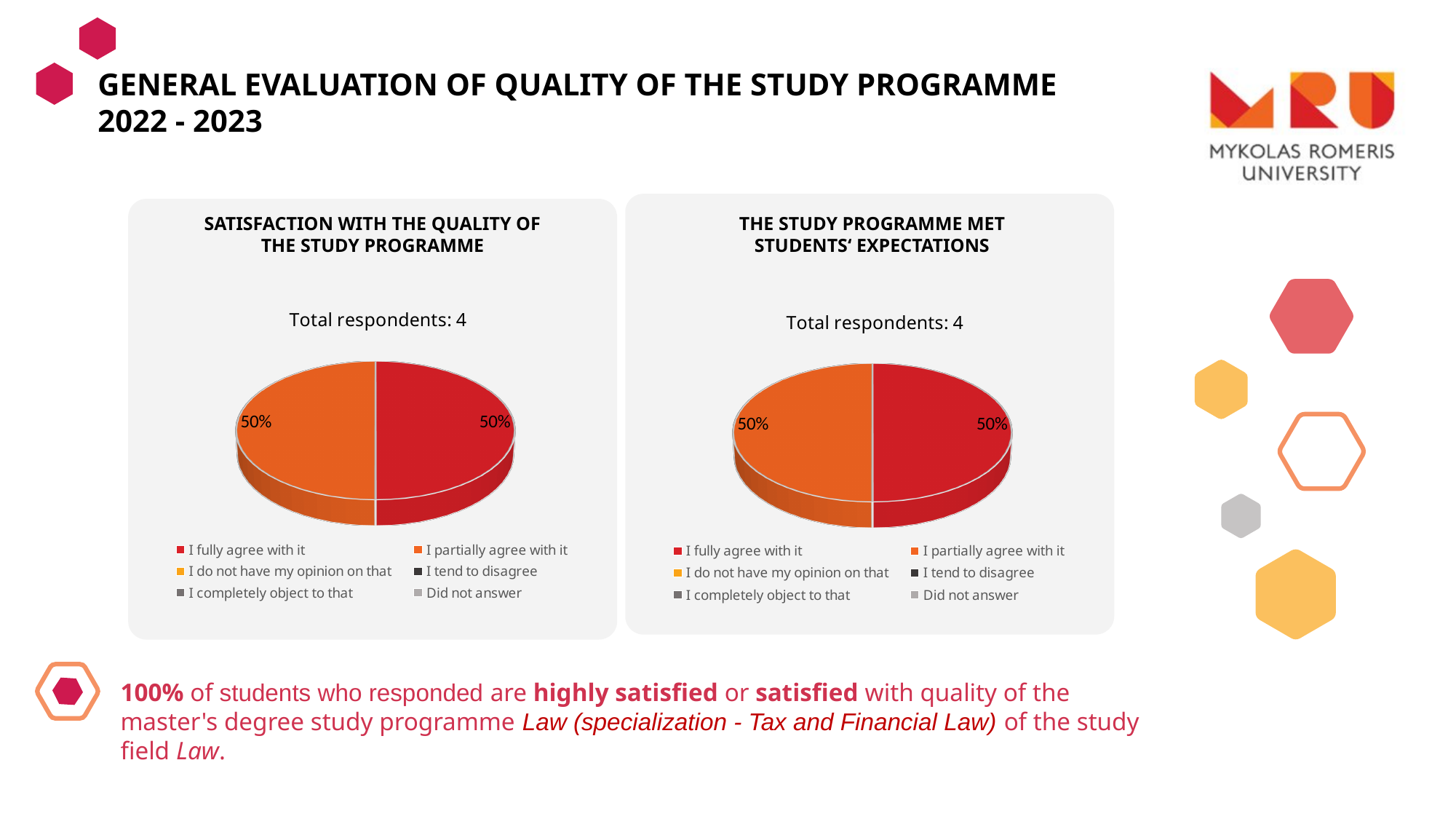
In the 'Satisfaction with the quality of the study programme' chart, what is the difference between the 'I fully agree with it' share and the 'I partially agree with it' share? 0% In the 'Satisfaction with the quality of the study programme' chart, what share of respondents fully agree with it? 50% What kind of chart is the 'The study programme met students' expectations' chart? Pie chart In the 'Satisfaction with the quality of the study programme' chart, which colour represents 'I fully agree with it'? Red In the 'The study programme met students' expectations' chart, what is the combined share of 'I fully agree with it' and 'I partially agree with it'? 100% In the 'The study programme met students' expectations' chart, what share of respondents partially agree with it? 50% How many total respondents are reported for the 'The study programme met students' expectations' chart? 4 In the 'The study programme met students' expectations' chart, what share of respondents fully agree with it? 50% How many entries does the legend of the 'Satisfaction with the quality of the study programme' chart list? 6 How many slices are visible in the 'The study programme met students' expectations' pie chart? 2 In the 'Satisfaction with the quality of the study programme' chart, what share of respondents partially agree with it? 50% What kind of chart is the 'Satisfaction with the quality of the study programme' chart? Pie chart